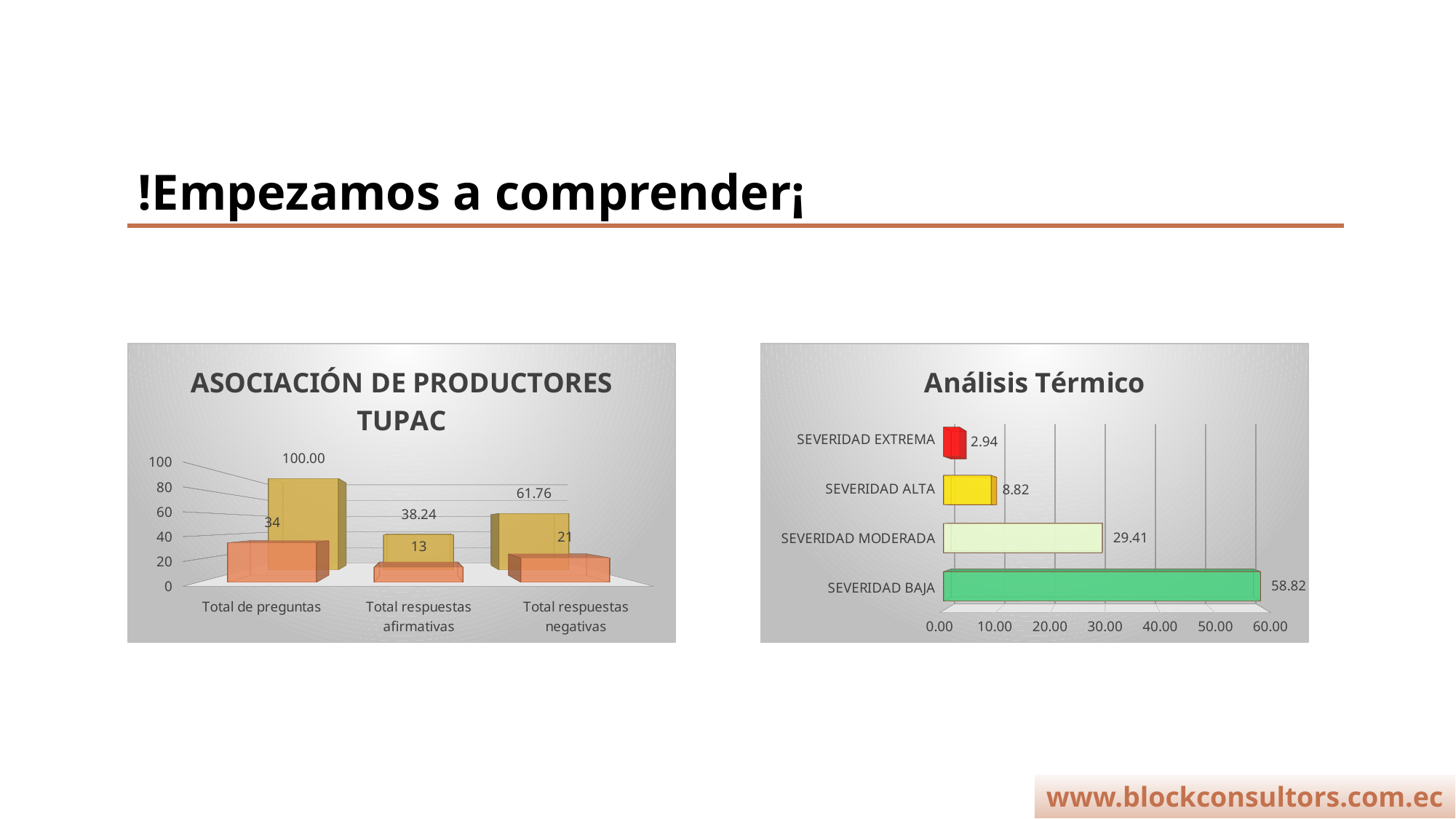
In the 'Análisis Térmico' chart, which category has the highest value? SEVERIDAD BAJA In the 'Análisis Térmico' chart, what is the value for SEVERIDAD MODERADA? 29.41 In the 'ASOCIACIÓN DE PRODUCTORES TUPAC' chart, what two values are labelled for 'Total respuestas afirmativas'? 13 and 38.24 In the 'Análisis Térmico' chart, what is the difference between SEVERIDAD BAJA and SEVERIDAD MODERADA? 29.41 In the 'Análisis Térmico' chart, how many categories are shown? 4 In the 'Análisis Térmico' chart, which category has the lowest value? SEVERIDAD EXTREMA In the 'ASOCIACIÓN DE PRODUCTORES TUPAC' chart, how many categories are on the x axis? 3 In the 'Análisis Térmico' chart, what is the value for SEVERIDAD EXTREMA? 2.94 In the 'Análisis Térmico' chart, what is the value for SEVERIDAD BAJA? 58.82 What kind of chart is 'Análisis Térmico'? Bar chart In the 'ASOCIACIÓN DE PRODUCTORES TUPAC' chart, what is the label on the tallest bar for 'Total de preguntas'? 100.00 In the 'ASOCIACIÓN DE PRODUCTORES TUPAC' chart, which is larger: the 61.76 label for 'Total respuestas negativas' or the 38.24 label for 'Total respuestas afirmativas'? 61.76 (Total respuestas negativas)